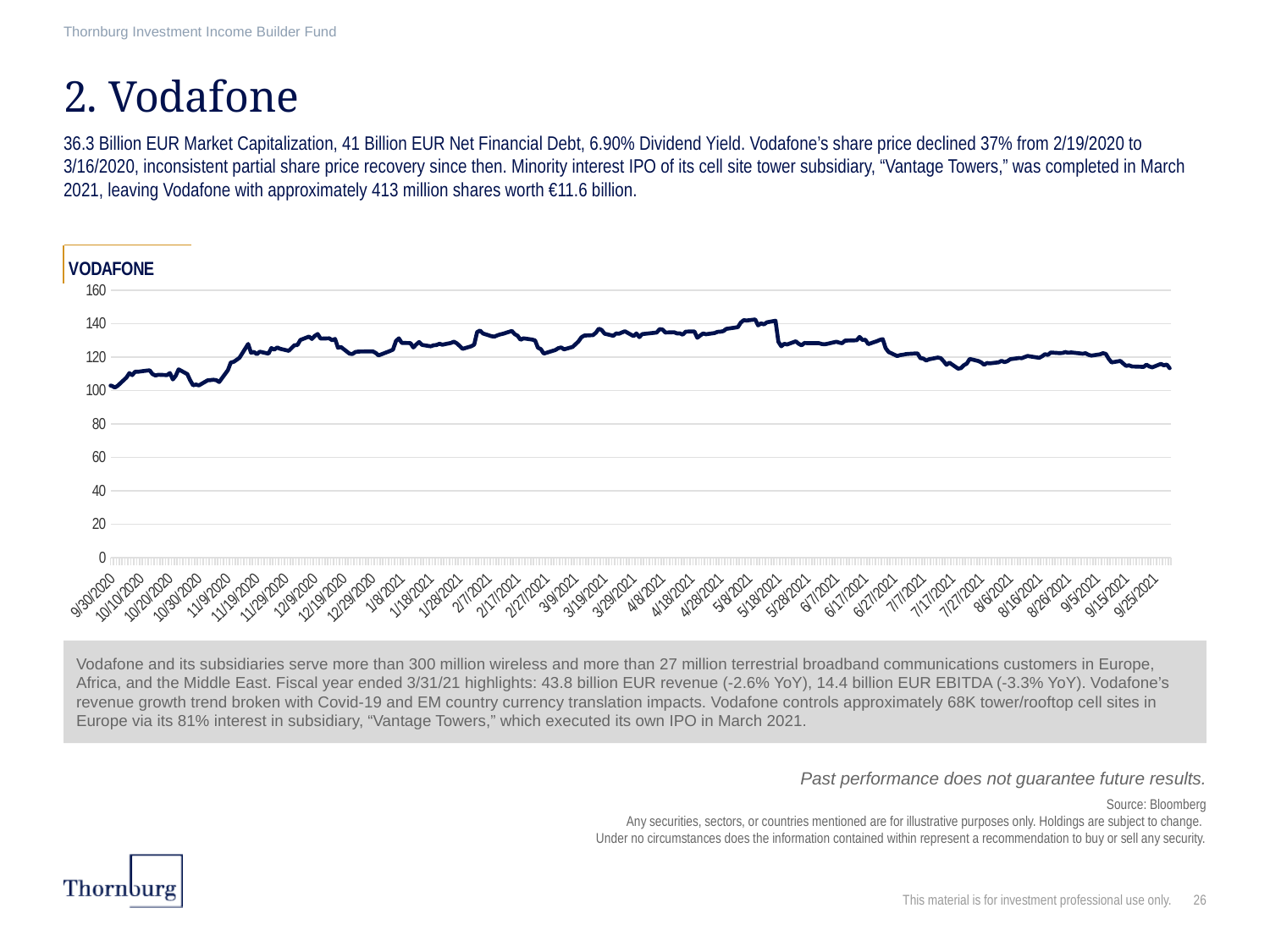
What is the title of the chart? VODAFONE Does the line ever fall below 80 at any point in the chart? No Between 5/8/2021 and 9/25/2021, does the line generally rise or fall? fall What kind of chart is shown on the slide? line chart What is the highest value shown on the chart's vertical axis? 160 Between 9/30/2020 and 12/9/2020, does the line generally rise or fall? rise Is the value for 9/25/2021 greater or less than 120? less Does the line ever rise above 160 at any point in the chart? No How many data series are plotted in the chart? 1